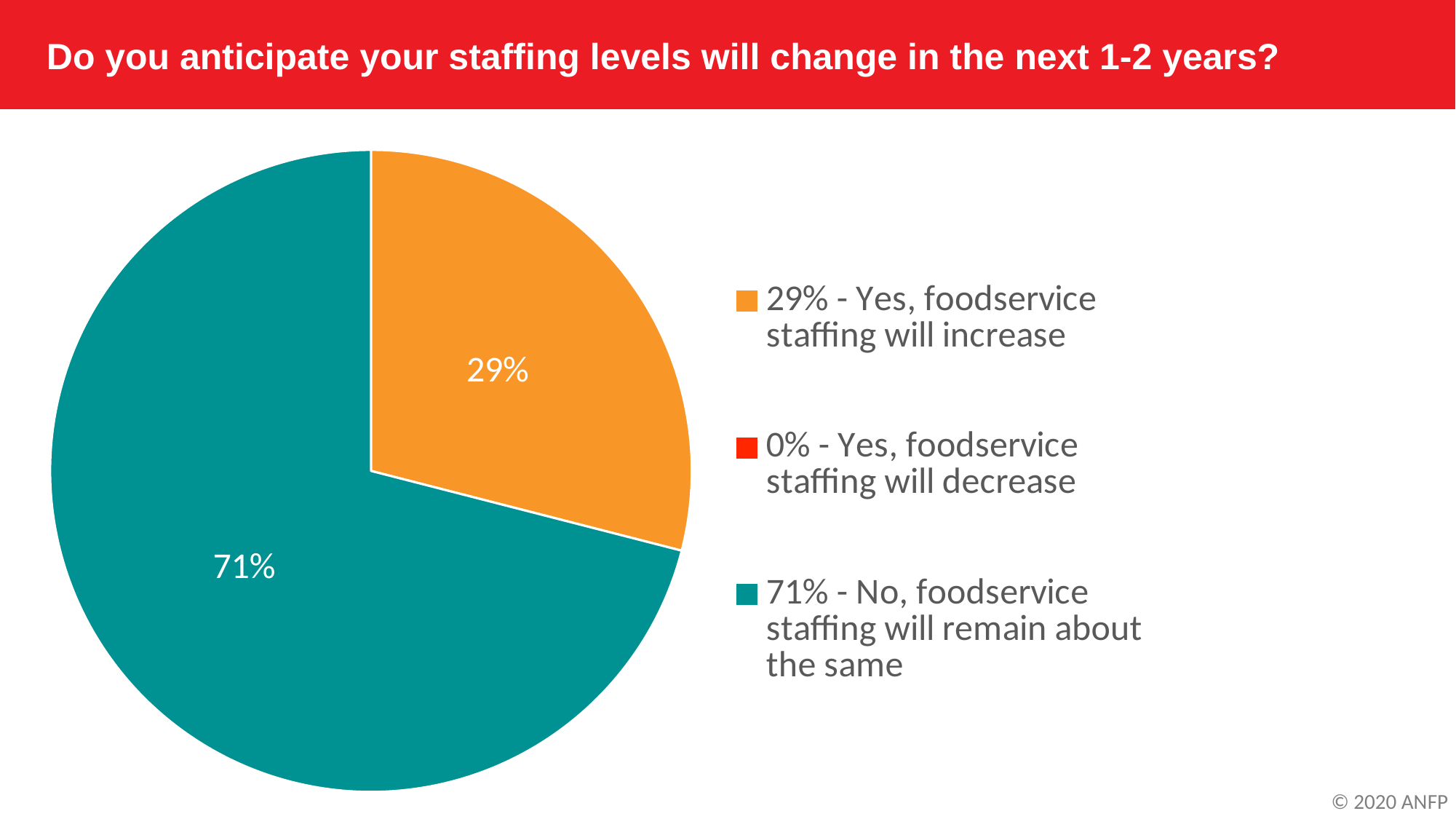
What is the difference in percentage points between respondents expecting staffing to remain about the same and those expecting it to increase? 42 What kind of chart is shown on the slide? Pie chart What percentage of respondents said foodservice staffing will increase? 29% What percentage of respondents said foodservice staffing will decrease? 0% Which response has the smallest share of the pie? Yes, foodservice staffing will decrease Which response has the largest share of the pie? No, foodservice staffing will remain about the same How many response categories does the legend list? 3 What is the title of the chart? Do you anticipate your staffing levels will change in the next 1-2 years? Which is larger: the share expecting staffing to increase or the share expecting it to remain about the same? Remain about the same What colour is the slice for 'No, foodservice staffing will remain about the same'? Teal Is the share of respondents expecting staffing to remain about the same greater or less than 50%? greater What percentage of respondents said foodservice staffing will remain about the same? 71%